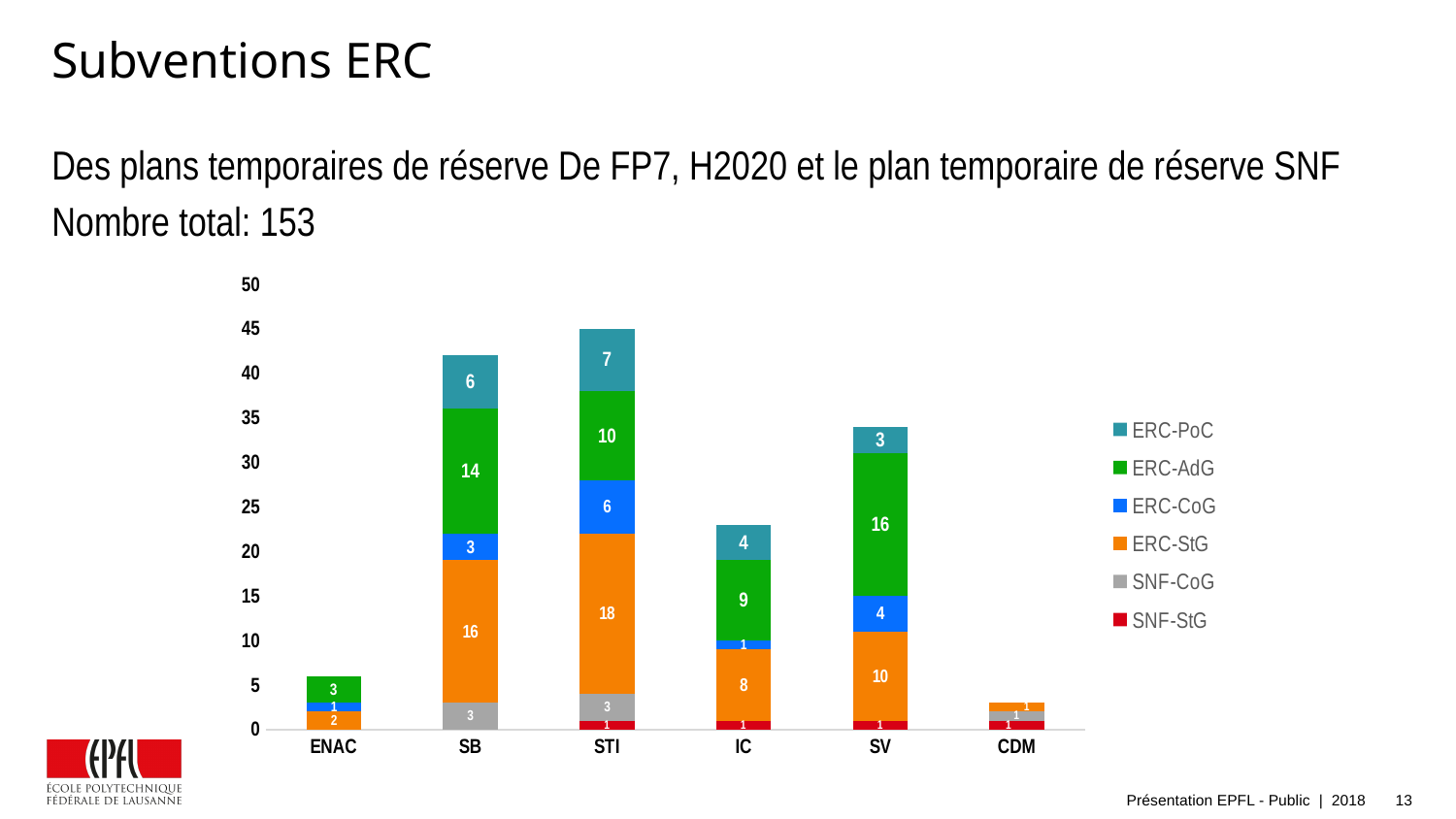
Which category has the highest total? STI What is the total of the stacked bar for SB? 42 What kind of chart is shown on the slide? stacked bar chart What is the ERC-StG value for STI? 18 Which is larger, the ERC-StG value for SB or for SV? SB How many series does the legend list? 6 How many categories are shown on the x axis? 6 What is the difference between the ERC-AdG values for SB and IC? 5 What is the ERC-AdG value for SV? 16 Which category has the lowest total? CDM What is the ERC-PoC value for SB? 6 What is the total of the stacked bar for STI? 45